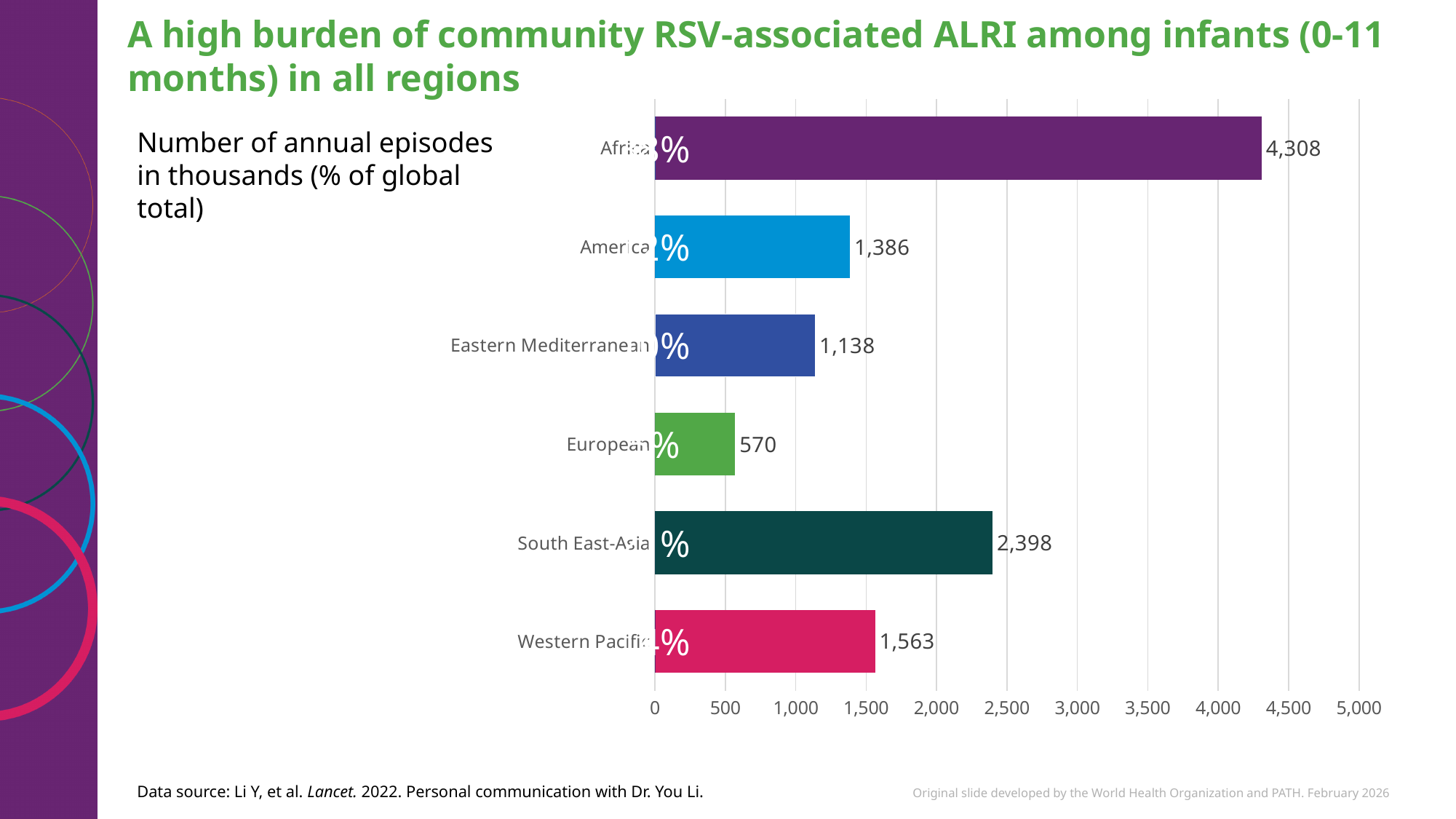
Which region has the highest number of annual episodes? Africa What is the number of annual episodes (in thousands) for Africa? 4,308 Which region has the lowest number of annual episodes? European How many regions are shown in the chart? 6 What is the number of annual episodes (in thousands) for Western Pacific? 1,563 What is the difference in annual episodes (in thousands) between Western Pacific and Eastern Mediterranean? 425 What is the number of annual episodes (in thousands) for South East-Asia? 2,398 What is the difference in annual episodes (in thousands) between Africa and South East-Asia? 1,910 Is the value for South East-Asia greater or less than 2,000? greater What is the number of annual episodes (in thousands) for the European region? 570 Which region has more annual episodes, Eastern Mediterranean or Western Pacific? Western Pacific What kind of chart is shown on the slide? Bar chart